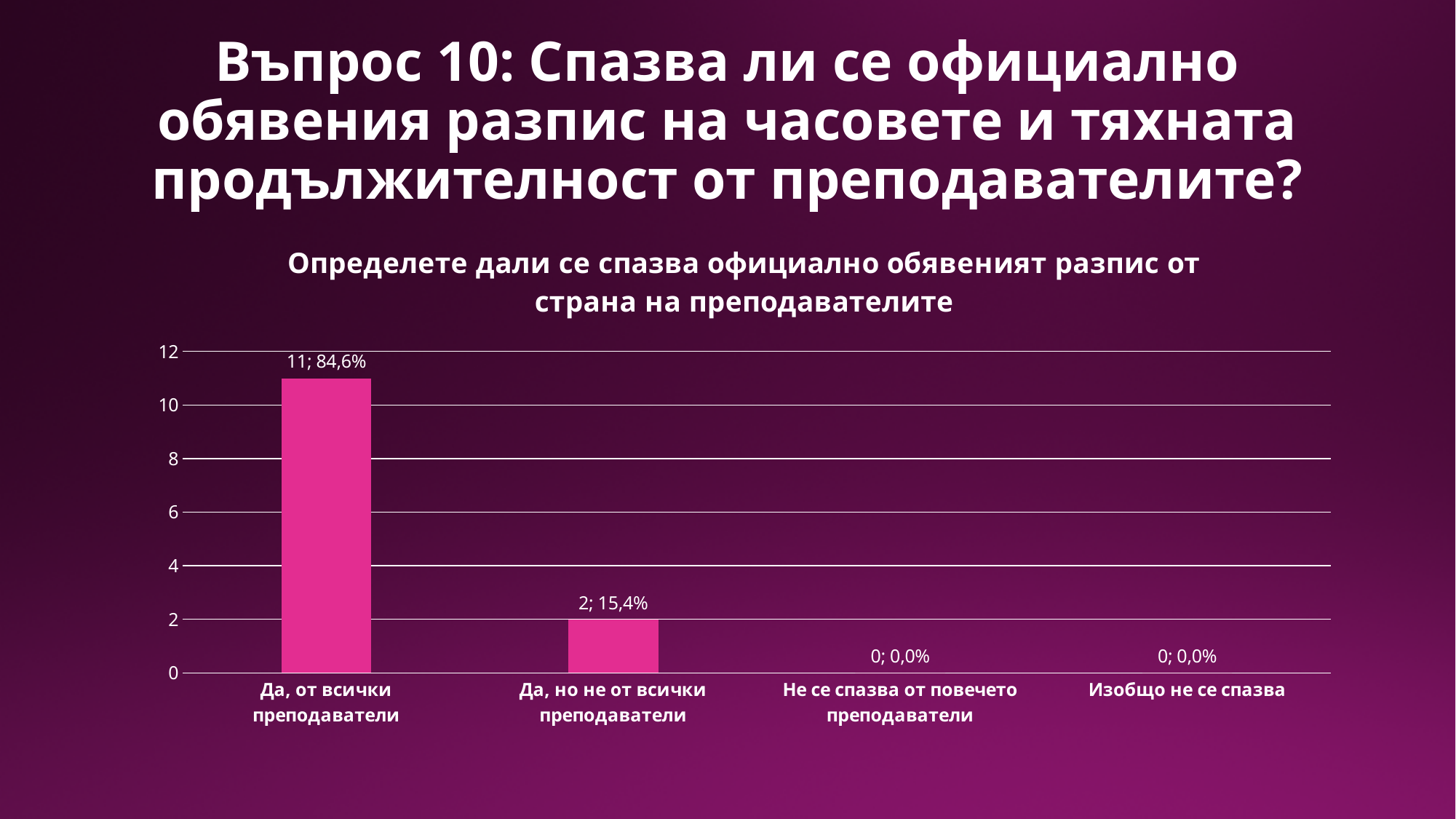
Is the value for "Да, от всички преподаватели" greater or less than 10? greater How many categories are shown on the x axis of the chart? 4 What is the difference in count between "Да, от всички преподаватели" and "Да, но не от всички преподаватели"? 9 What is the data label for the category "Не се спазва от повечето преподаватели"? 0; 0,0% What is the data label for the category "Да, от всички преподаватели"? 11; 84,6% Which is larger: the value for "Да, от всички преподаватели" or the value for "Да, но не от всички преподаватели"? Да, от всички преподаватели What is the data label for the category "Изобщо не се спазва"? 0; 0,0% Which category has the highest value? Да, от всички преподаватели What type of chart is shown on the slide? bar chart What is the data label for the category "Да, но не от всички преподаватели"? 2; 15,4% What is the title of the chart? Определете дали се спазва официално обявеният разпис от страна на преподавателите Do the values rise or fall from left to right along the x axis? fall